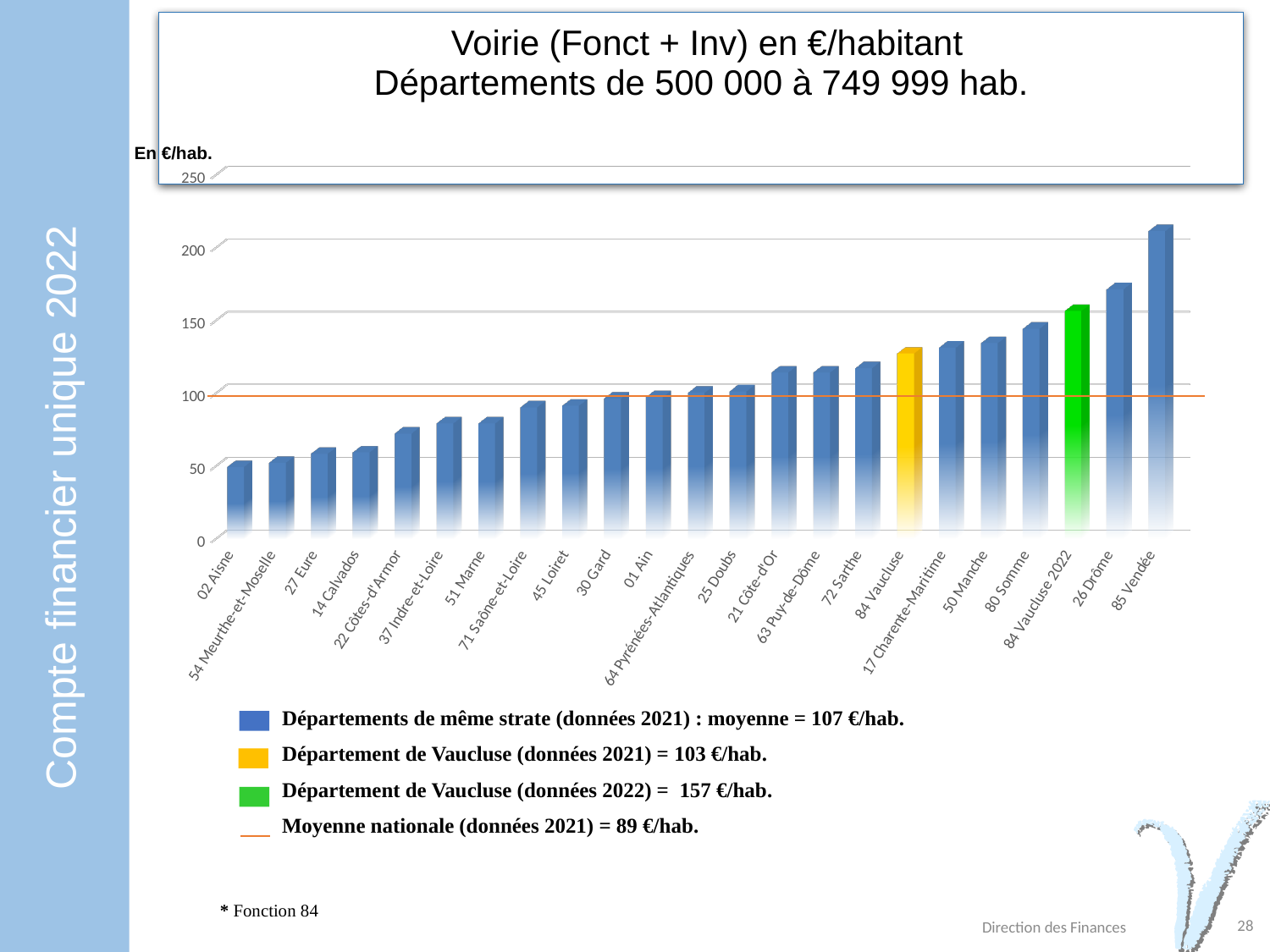
What is the average (moyenne) for départements de même strate (données 2021) given in the legend? 107 €/hab. Which is larger, the Vaucluse value for 2022 or for 2021? 2022 How many bars (départements) are plotted on the chart? 23 Do the bar values rise or fall from left to right along the x axis? Rise What colour is the bar for 84 Vaucluse 2022? Green What is the moyenne nationale (données 2021) shown in the legend? 89 €/hab. According to the legend, what is the value for Département de Vaucluse (données 2021)? 103 €/hab. What is the difference between the Vaucluse 2022 value and the Vaucluse 2021 value? 54 €/hab. What kind of chart is shown on the slide? Bar chart Is the value for 85 Vendée greater or less than 200? greater According to the legend, what is the value for Département de Vaucluse (données 2022)? 157 €/hab. Which département has the highest value on the chart? 85 Vendée